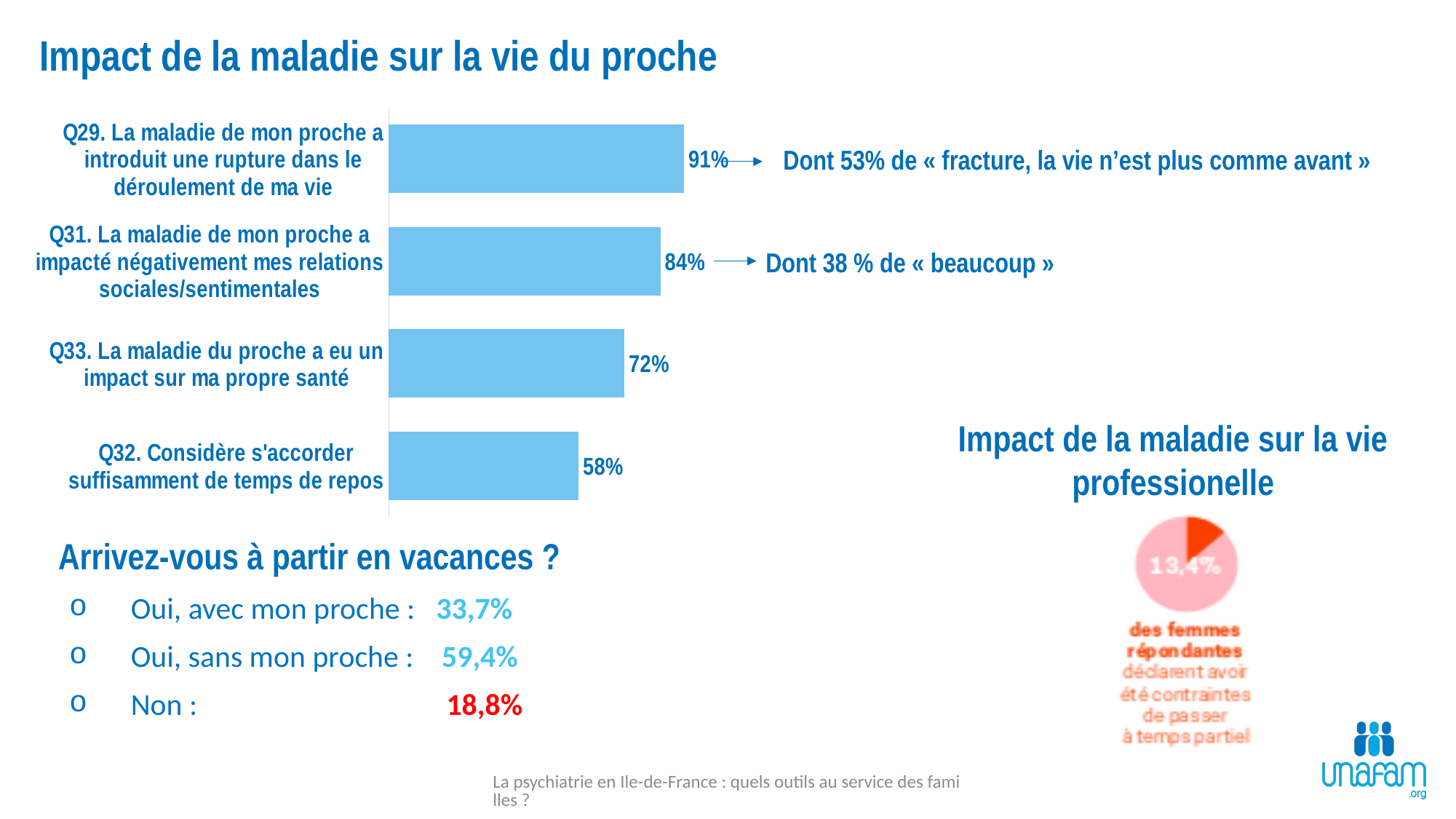
On the pie chart titled 'Impact de la maladie sur la vie professionelle', what share of women respondents declare having been forced to go part-time? 13,4% On the bar chart, what is the value for Q29 (La maladie de mon proche a introduit une rupture dans le déroulement de ma vie)? 91% On the bar chart, which question has the lowest value? Q32 On the bar chart, which is larger: the value for Q33 or the value for Q32? Q33 On the bar chart, which question has the highest value? Q29 On the bar chart, what is the difference between the values for Q31 and Q33? 12% On the bar chart, what is the value for Q32 (Considère s'accorder suffisamment de temps de repos)? 58% On the bar chart, what is the value for Q31 (impacté négativement mes relations sociales/sentimentales)? 84% How many bars does the bar chart show? 4 What kind of chart is used to show the Q29–Q32 results? Bar chart On the bar chart, what is the difference between the values for Q29 and Q32? 33% On the bar chart, what is the value for Q33 (impact sur ma propre santé)? 72%